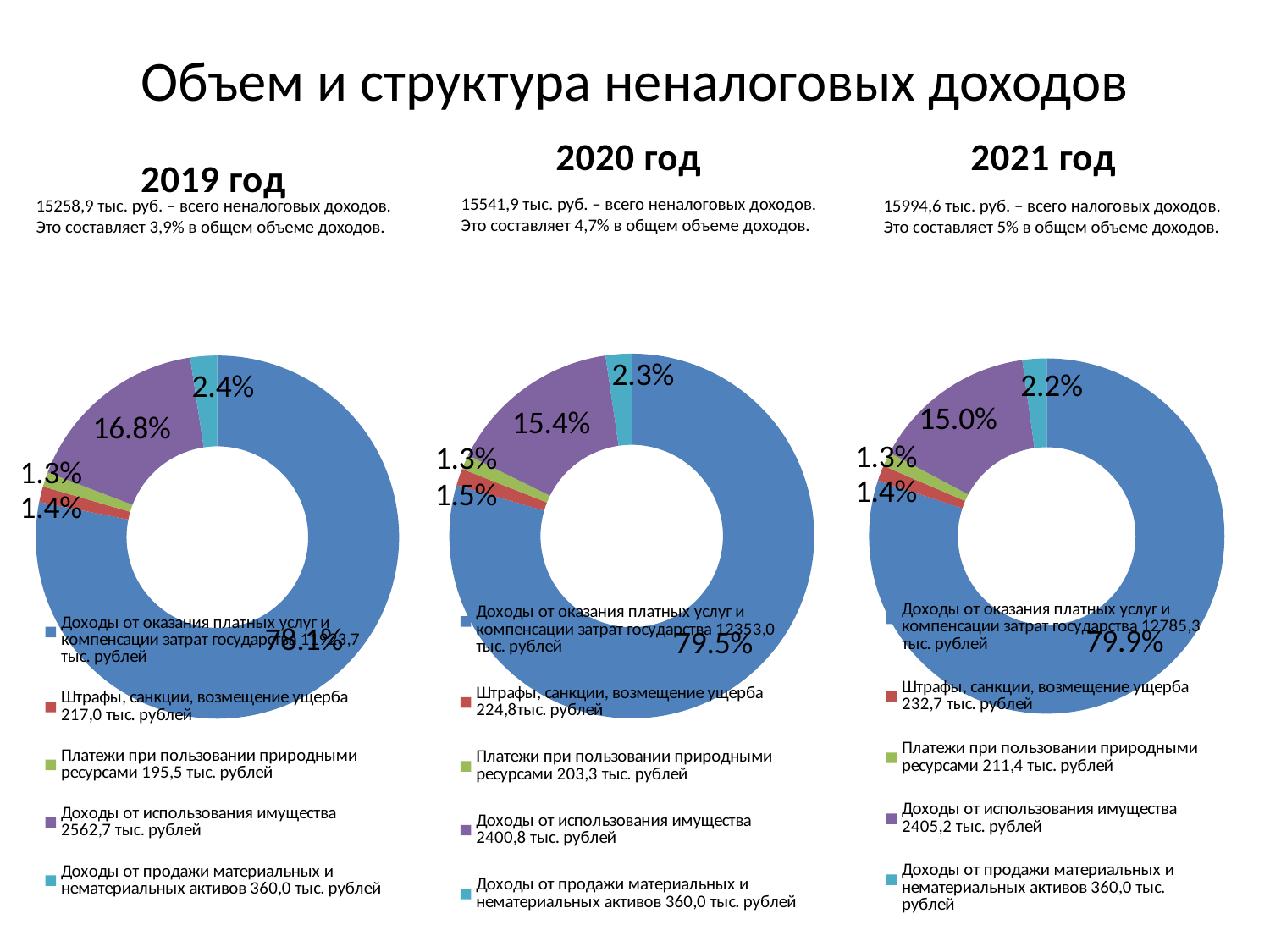
According to the 2021 chart legend, how much revenue came from 'Штрафы, санкции, возмещение ущерба'? 232,7 тыс. рублей In the 2019 chart, which category has the smallest share? Платежи при пользовании природными ресурсами According to the 2020 chart legend, how much revenue came from 'Платежи при пользовании природными ресурсами'? 203,3 тыс. рублей What type of chart is used for the 2021 data? Doughnut chart In the 2019 chart, which is larger: the share for 'Штрафы, санкции, возмещение ущерба' or the share for 'Доходы от продажи материальных и нематериальных активов'? Доходы от продажи материальных и нематериальных активов In the 2019 chart, what share of non-tax revenue comes from 'Доходы от использования имущества'? 16.8% What is the title of the slide containing the three charts? Объем и структура неналоговых доходов In the 2020 chart, what share is shown for 'Доходы от оказания платных услуг и компенсации затрат государства'? 79.5% How many categories does the 2020 chart show? 5 In the 2021 chart, what share is shown for 'Доходы от продажи материальных и нематериальных активов'? 2.2% In the 2021 chart, which category has the largest share? Доходы от оказания платных услуг и компенсации затрат государства In the 2020 chart, what is the difference between the share for 'Доходы от использования имущества' and the share for 'Доходы от продажи материальных и нематериальных активов'? 13.1%